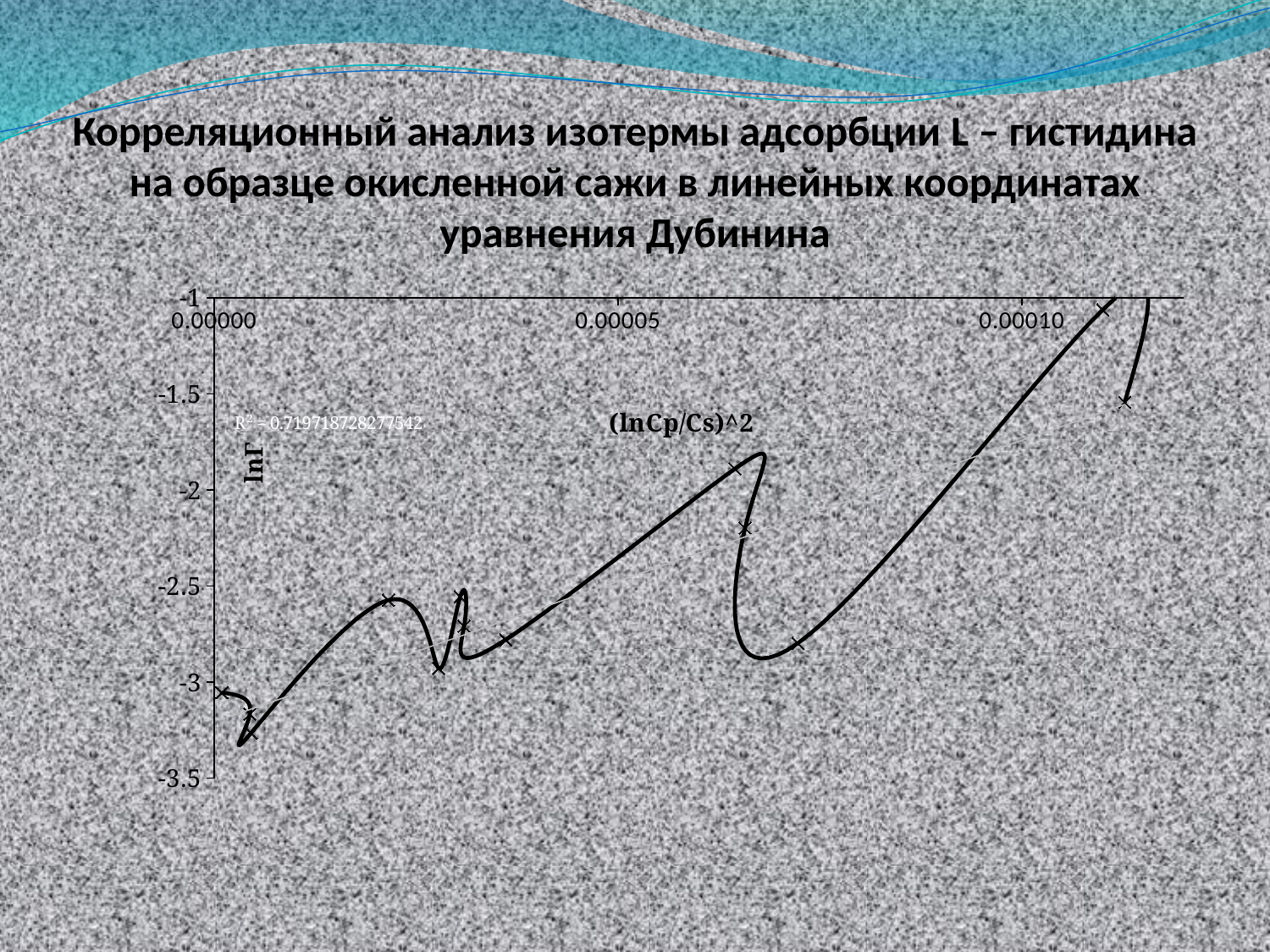
Is the highest lnГ value on the chart found at the left end or the right end of the x axis? right end Is the lnГ value of the leftmost point (near x = 0.00000) greater or less than -2.5? less Overall, do the lnГ values rise or fall as (lnCp/Cs)^2 increases along the x axis? rise Is the lnГ value of the highest point near x = 0.00005 greater or less than -2.5? greater Is the lowest lnГ value on the chart found at the left end or the right end of the x axis? left end What is the title of the chart on the slide? Корреляционный анализ изотермы адсорбции L – гистидина на образце окисленной сажи в линейных координатах уравнения Дубинина What kind of chart is shown on the slide? A scatter chart with a smoothed line What R² value is printed on the chart? R² = 0.719718728277542 Which has the larger lnГ value: the leftmost point near x = 0.00000 or the rightmost point near x = 0.00011? the rightmost point Is the x value of the rightmost point greater or less than 0.00010? greater